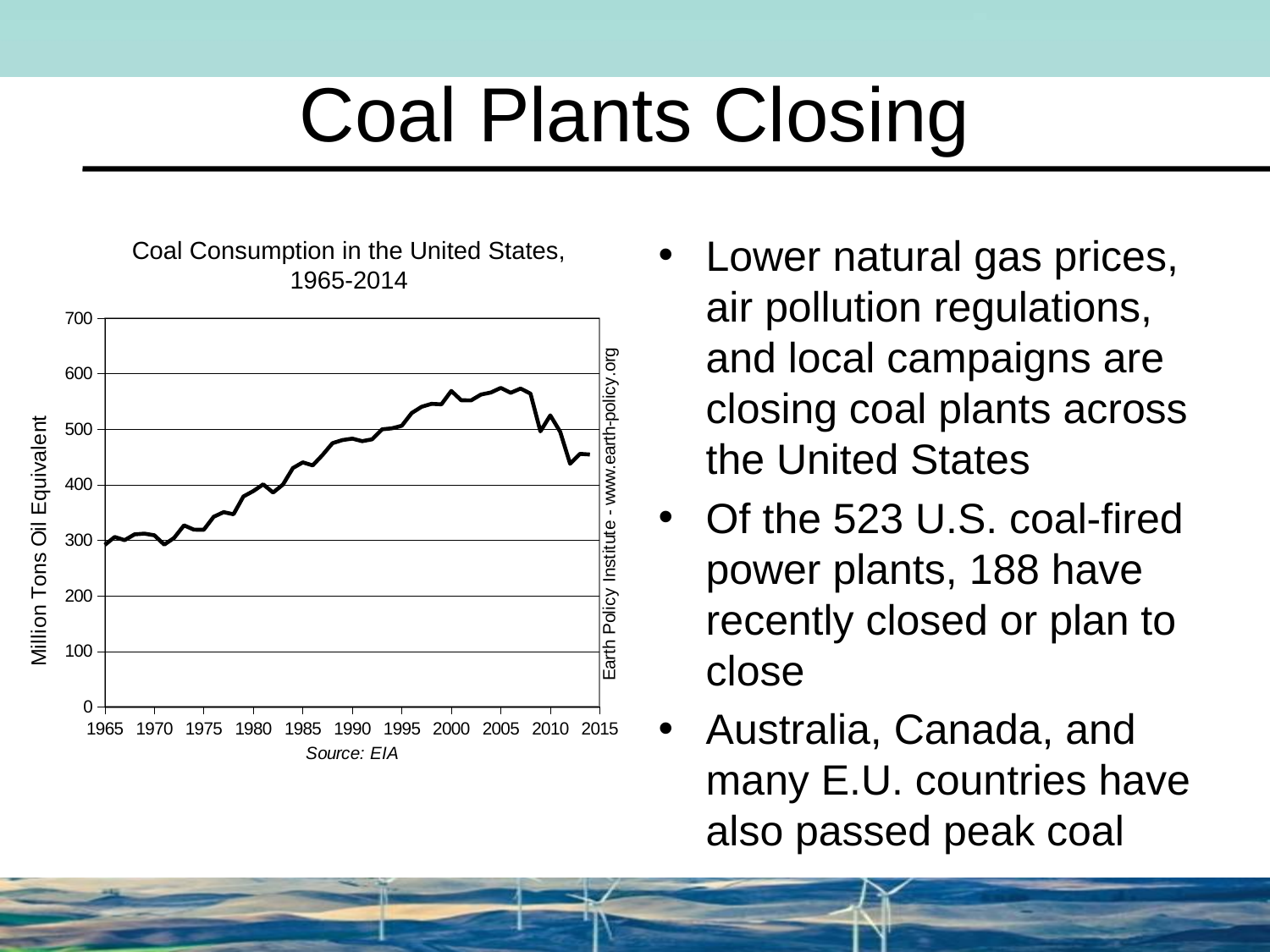
Is the value for 2014 greater or less than 500? less Does coal consumption rise or fall between 2008 and 2014? fall What is the label of the vertical axis of the chart? Million Tons Oil Equivalent Is the value for 2014 greater or less than 400? greater Is the value for 1985 greater or less than 400? greater Does coal consumption rise or fall between 1965 and 2005? rise Which year has the higher coal consumption, 1970 or 2000? 2000 What is the title of the chart? Coal Consumption in the United States, 1965-2014 What kind of chart is shown on the slide? line chart